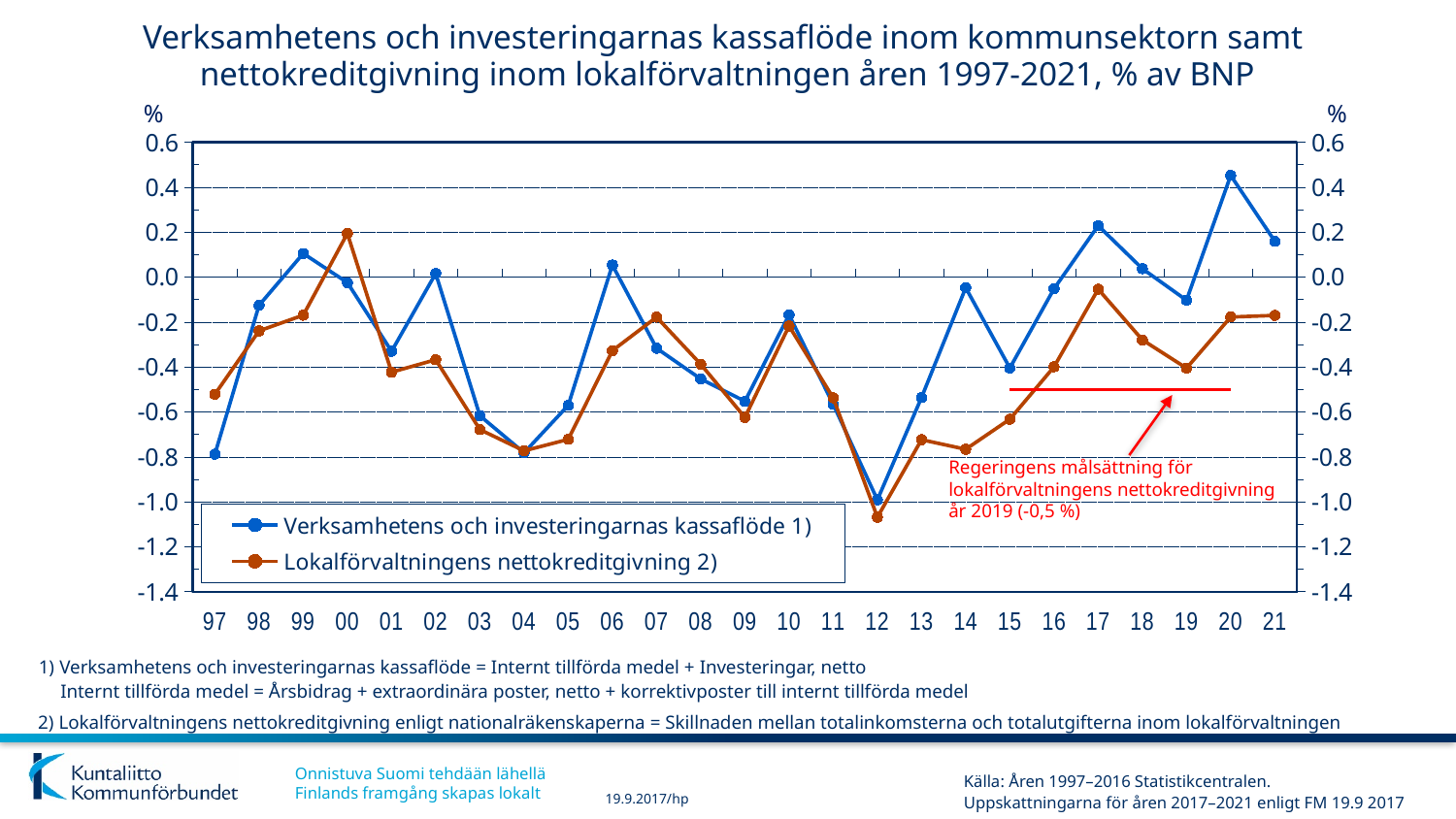
According to the red annotation, what is the government's target for local government net lending in 2019? -0,5 % Is the value for 'Verksamhetens och investeringarnas kassaflöde 1)' in 12 greater or less than -0.8? less How many series does the legend list? 2 What kind of chart is shown on the slide? line chart How many years are plotted along the x axis? 25 Is the value for 'Lokalförvaltningens nettokreditgivning 2)' in 00 greater or less than 0.0? greater In which year does the series 'Verksamhetens och investeringarnas kassaflöde 1)' reach its highest value? 20 Does the series 'Lokalförvaltningens nettokreditgivning 2)' rise or fall from 14 to 17? rise In which year does the series 'Lokalförvaltningens nettokreditgivning 2)' reach its highest value? 00 Is the value for 'Verksamhetens och investeringarnas kassaflöde 1)' in 20 greater or less than 0.2? greater In 17, which series has the larger value: 'Verksamhetens och investeringarnas kassaflöde 1)' or 'Lokalförvaltningens nettokreditgivning 2)'? Verksamhetens och investeringarnas kassaflöde 1) In which year does the series 'Lokalförvaltningens nettokreditgivning 2)' reach its lowest value? 12